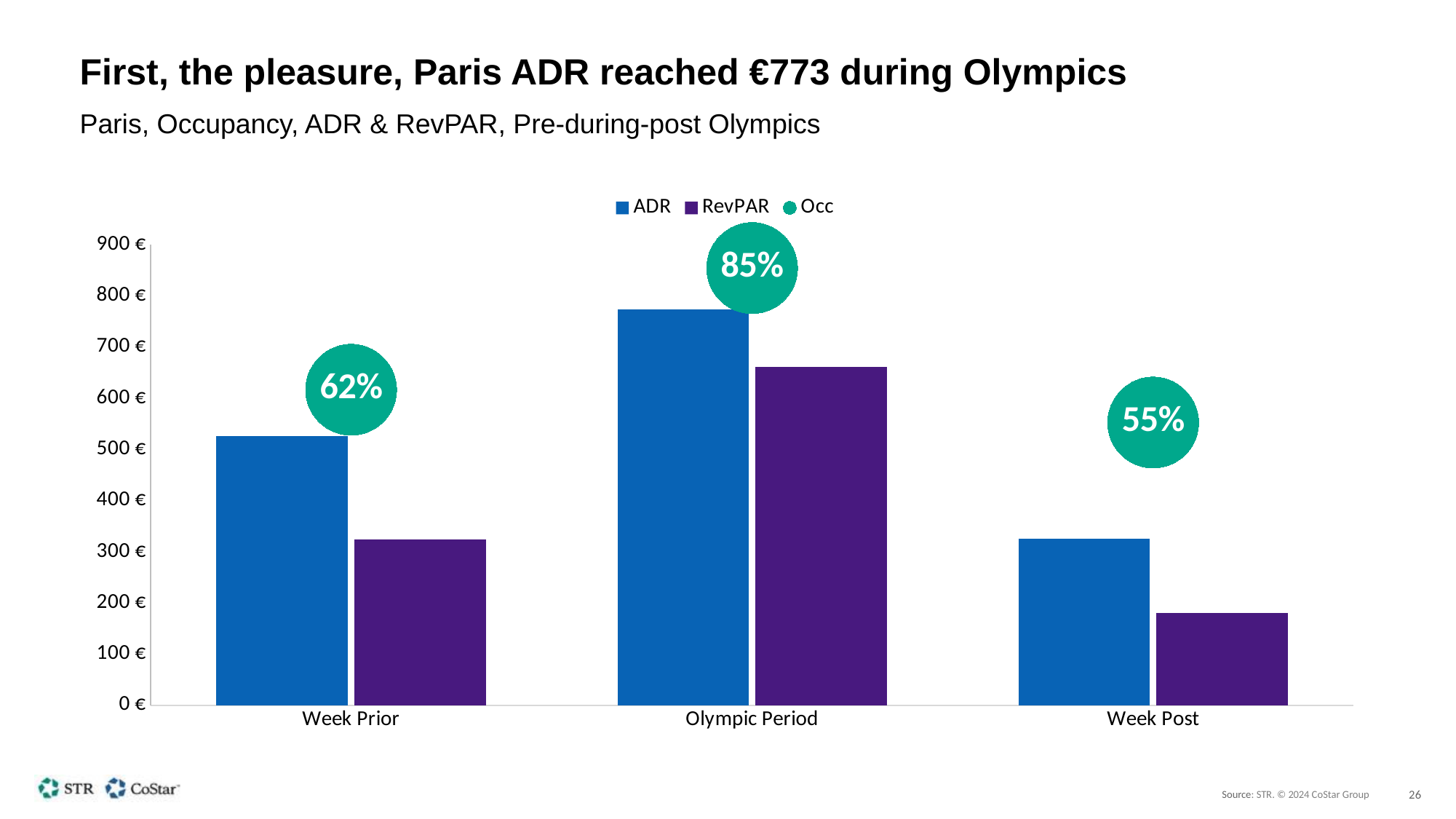
By how many percentage points is occupancy in the Olympic Period higher than in Week Prior? 23 percentage points Which period has the lowest occupancy? Week Post Is the RevPAR value for Week Post greater or less than 200 €? less How many periods are shown on the x axis? 3 What is the occupancy (Occ) shown for Week Post? 55% What is the occupancy (Occ) shown for Week Prior? 62% How many series does the legend list? 3 Which period has the highest occupancy? Olympic Period Is the ADR value for Week Prior greater or less than 500 €? greater Is the RevPAR value for the Olympic Period greater or less than 600 €? greater What is the occupancy (Occ) shown for the Olympic Period? 85% Which period has the highest ADR bar? Olympic Period